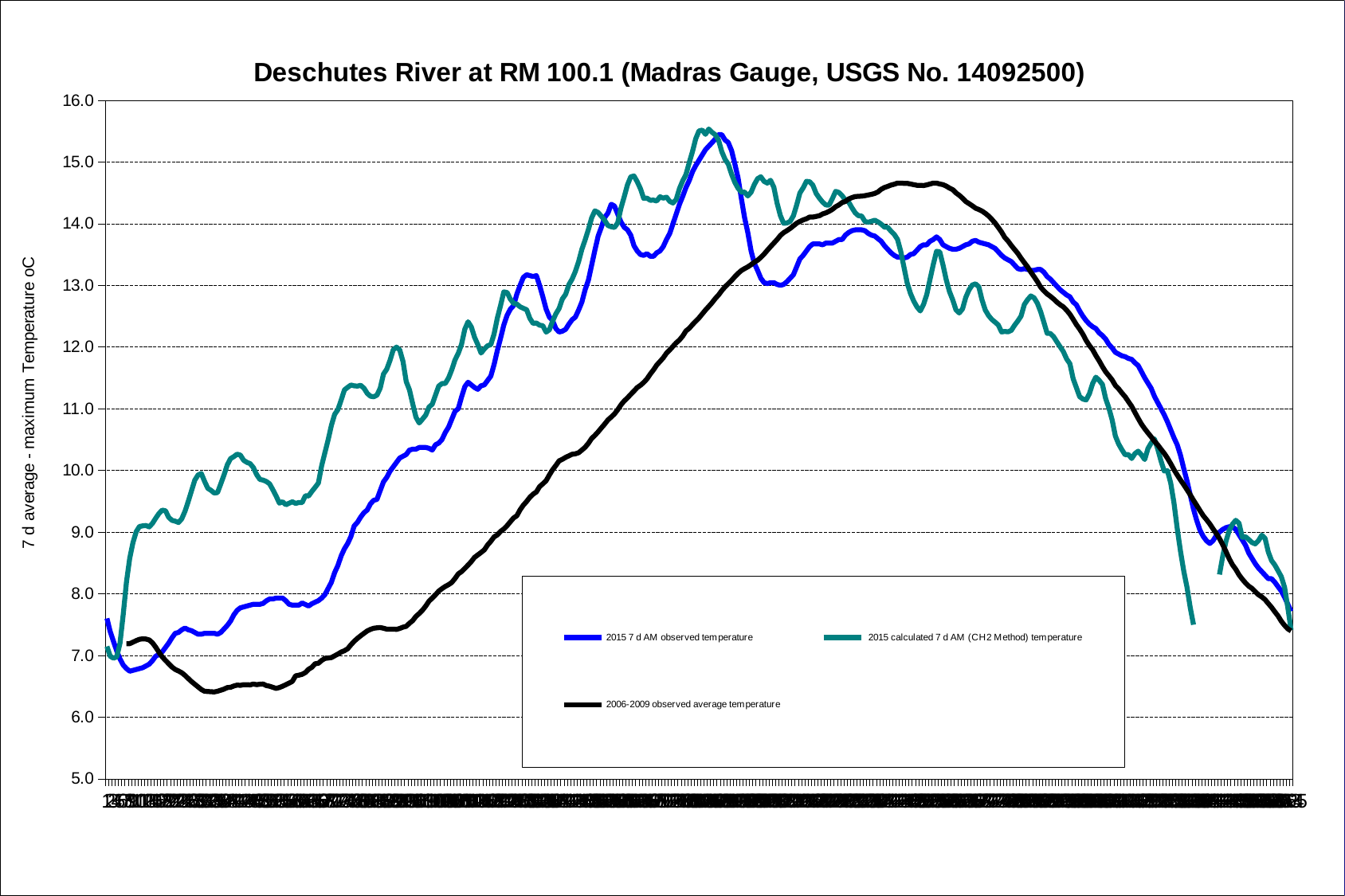
Does the 2006-2009 observed average temperature line rise or fall across the left half of the x axis? rise What is the label on the vertical axis? 7 d average - maximum Temperature oC Which of the three series has the lowest peak value? 2006-2009 observed average temperature What kind of chart is shown on the slide? line chart Is the peak value of the 2006-2009 observed average temperature line greater or less than 14.0? greater What is the title of the chart? Deschutes River at RM 100.1 (Madras Gauge, USGS No. 14092500) Is the lowest value of the 2006-2009 observed average temperature line greater or less than 7.0? less Is the peak value of the 2015 7 d AM observed temperature line greater or less than 15.0? greater Which reaches a higher peak: the 2015 7 d AM observed temperature or the 2006-2009 observed average temperature? 2015 7 d AM observed temperature Does the 2015 7 d AM observed temperature line rise or fall across the right-hand quarter of the x axis? fall How many series does the legend list? 3